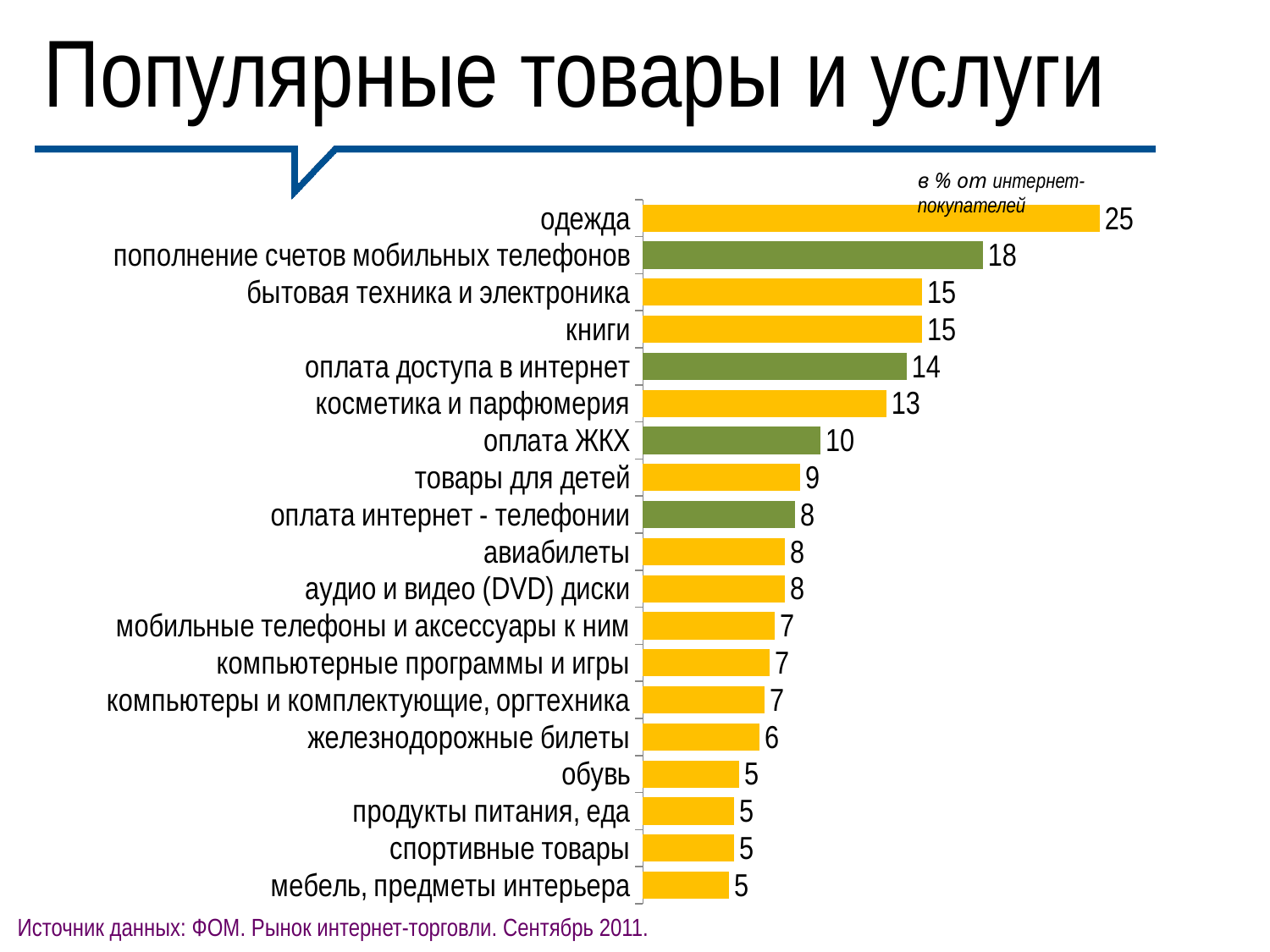
What is the value for оплата ЖКХ? 10 What is the title of the slide? Популярные товары и услуги What is the lowest value shown on the chart? 5 Which category has the highest value? одежда What is the value for пополнение счетов мобильных телефонов? 18 What is the value for одежда? 25 What is the difference between the values for косметика и парфюмерия and товары для детей? 4 How many categories are shown on the chart? 19 Which is larger, the value for оплата доступа в интернет or the value for оплата ЖКХ? оплата доступа в интернет What is the difference between the values for одежда and пополнение счетов мобильных телефонов? 7 What kind of chart is shown on the slide? bar chart What is the value for железнодорожные билеты? 6